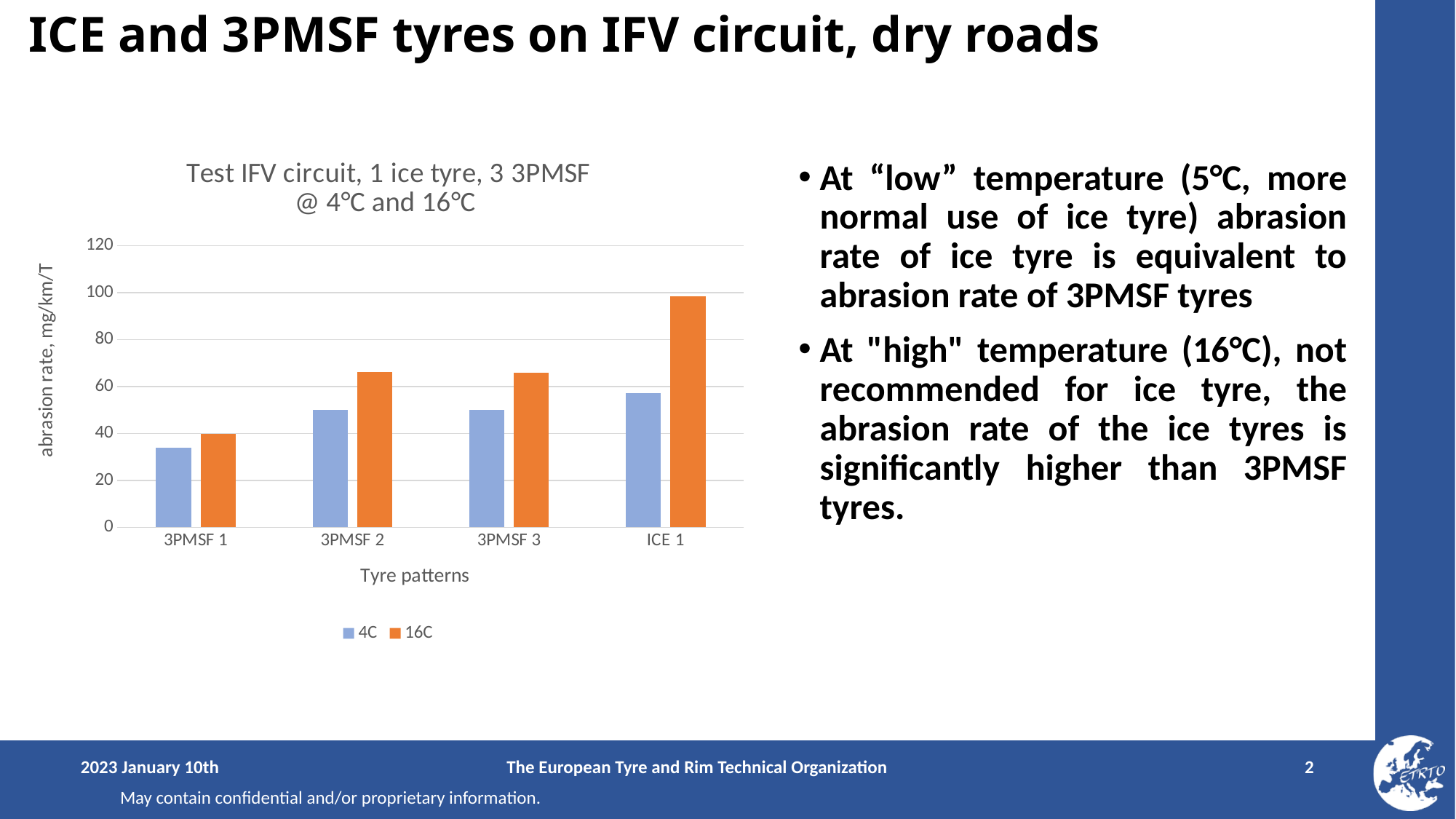
For 3PMSF 3, which series has the larger abrasion rate, 4C or 16C? 16C What is the label of the y axis of the chart? abrasion rate, mg/km/T Which tyre pattern has the lowest abrasion rate at 4C? 3PMSF 1 Which tyre pattern has the highest abrasion rate at 16C? ICE 1 How many series does the chart legend list? 2 Is the 16C abrasion rate for ICE 1 greater or less than 80? greater At 16C, which has the larger abrasion rate: ICE 1 or 3PMSF 2? ICE 1 What kind of chart is shown on the slide? bar chart How many tyre patterns are shown on the x axis of the chart? 4 Is the 4C abrasion rate for ICE 1 greater or less than 50? greater What are the two entries in the chart legend? 4C and 16C Is the 4C abrasion rate for 3PMSF 1 greater or less than 40? less